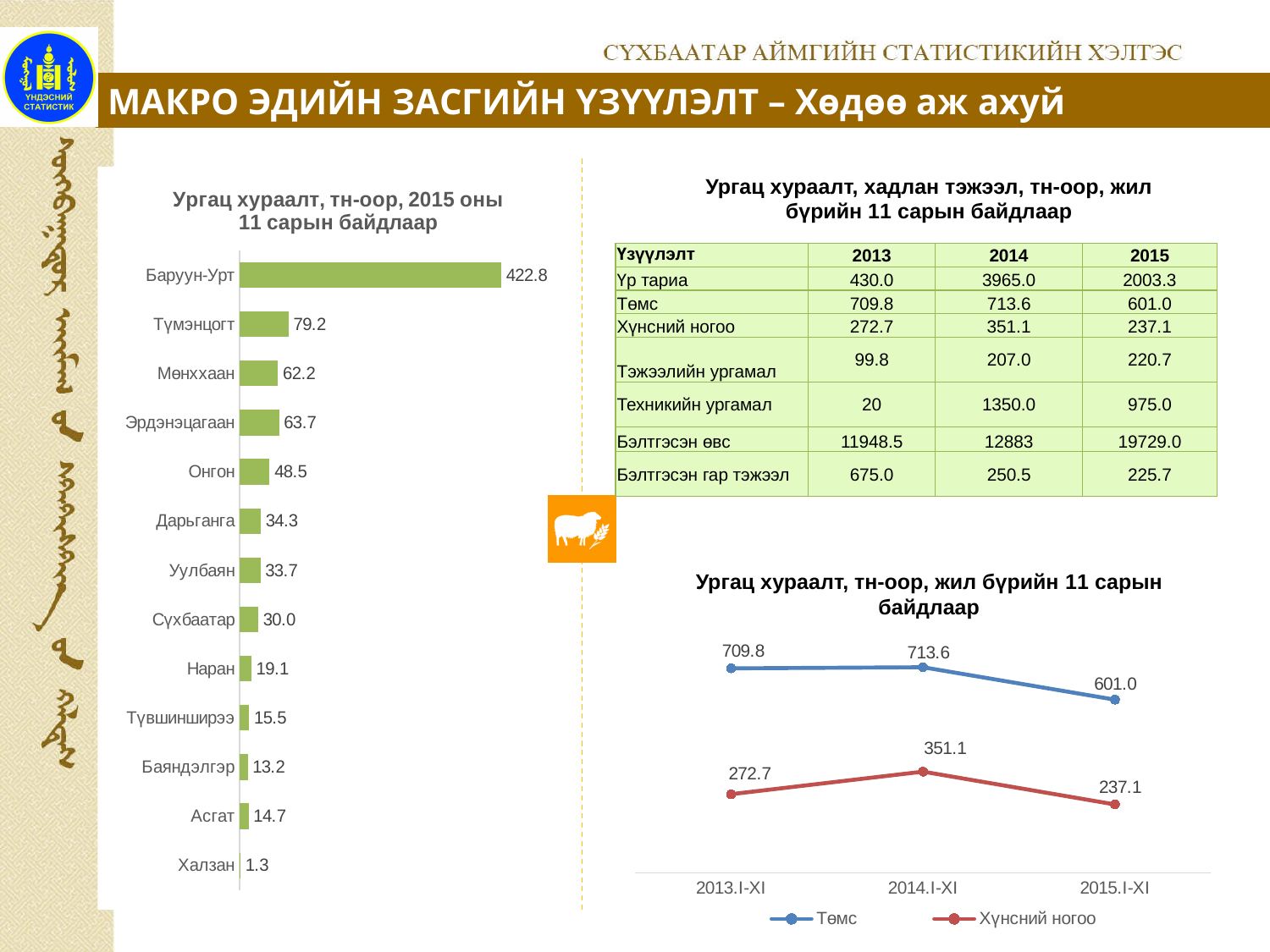
How many series does the legend of the line chart at the bottom right list? 2 What kind of chart is the chart on the left of the slide? Bar chart In the bar chart on the left, which is larger, the value for Дарьганга or the value for Уулбаян? Дарьганга In the bar chart on the left, what is the difference between the values for Түмэнцогт and Мөнххаан? 17.0 How many categories are shown in the bar chart on the left? 13 In the line chart titled "Ургац хураалт, тн-оор, жил бүрийн 11 сарын байдлаар", what is the value for Төмс at 2015.I-XI? 601.0 In the line chart at the bottom right, does the Төмс series rise or fall from 2014.I-XI to 2015.I-XI? Fall In the bar chart on the left, what is the value for Онгон? 48.5 In the bar chart on the left, which category has the highest value? Баруун-Урт In the bar chart titled "Ургац хураалт, тн-оор, 2015 оны 11 сарын байдлаар", what is the value for Баруун-Урт? 422.8 In the bar chart on the left, which category has the lowest value? Халзан In the line chart at the bottom right, what is the value for Хүнсний ногоо at 2014.I-XI? 351.1